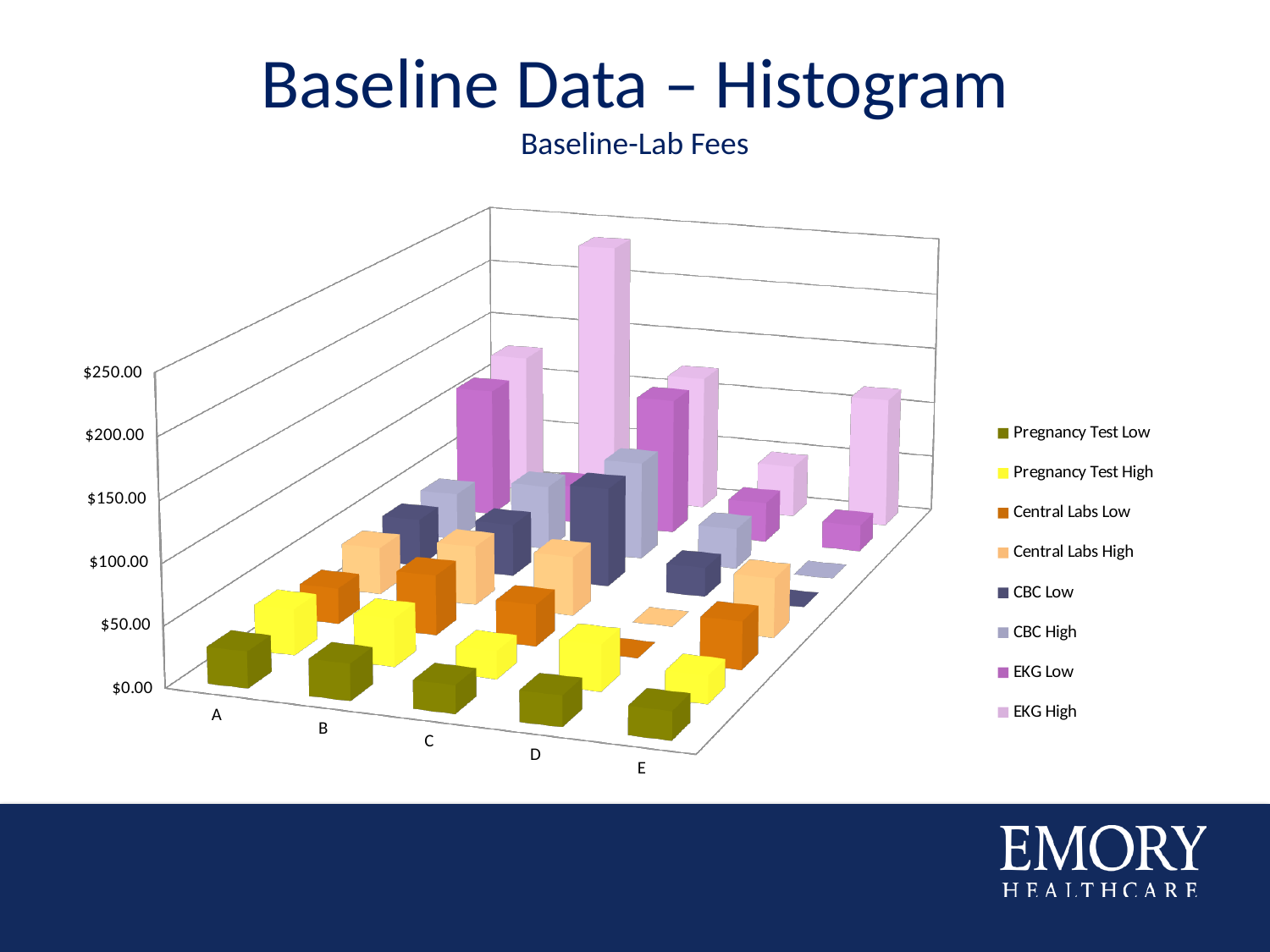
Is the value for EKG High at category C greater or less than $200.00? less Is the value for Central Labs High at category D greater or less than $50.00? less For which category is the EKG High bar the tallest? B Which series is listed first in the chart legend? Pregnancy Test Low Is the value for Pregnancy Test Low at category A greater or less than $50.00? less What kind of chart is shown on the slide? bar chart How many series does the chart legend list? 8 How many categories are shown along the x axis of the chart? 5 What is the highest value labelled on the vertical axis of the chart? $250.00 Which series has the tallest bar in the chart? EKG High What is the title of the chart? Baseline-Lab Fees